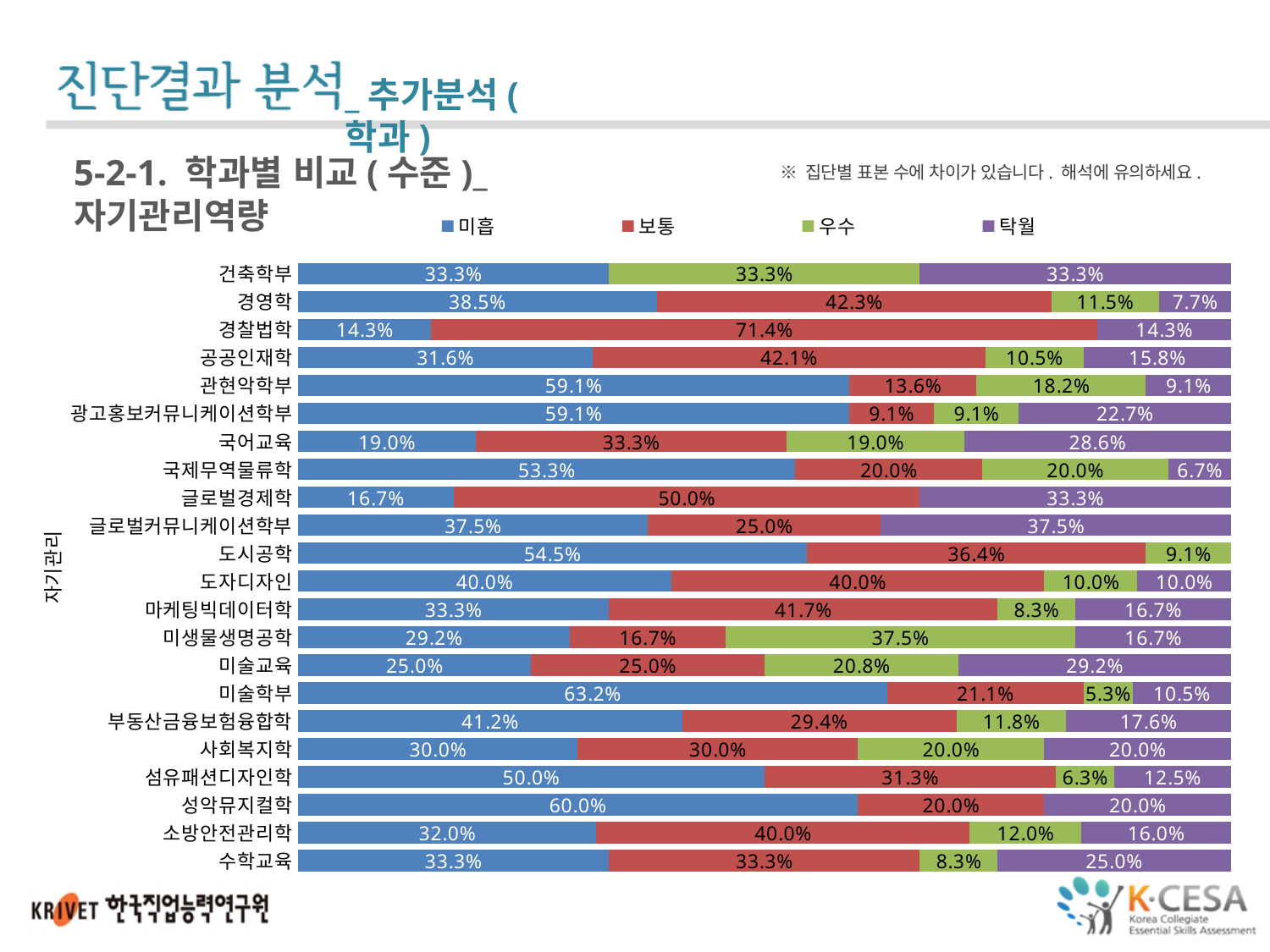
What is the 탁월 value for 글로벌커뮤니케이션학부? 37.5% Which department has the lowest 미흡 value? 경찰법학 How many series does the legend list? 4 How many departments (categories) are plotted in the chart? 22 What is the 미흡 value for 미술학부? 63.2% What is the difference between the 미흡 values of 관현악학부 and 국어교육? 40.1% What type of chart is shown on the slide? stacked bar chart What is the 보통 value for 경찰법학? 71.4% Which is larger, the 우수 value for 미생물생명공학 or the 우수 value for 소방안전관리학? 미생물생명공학 What is the 우수 value for 섬유패션디자인학? 6.3% Which department has the highest 미흡 value? 미술학부 Which legend entry is shown in purple? 탁월